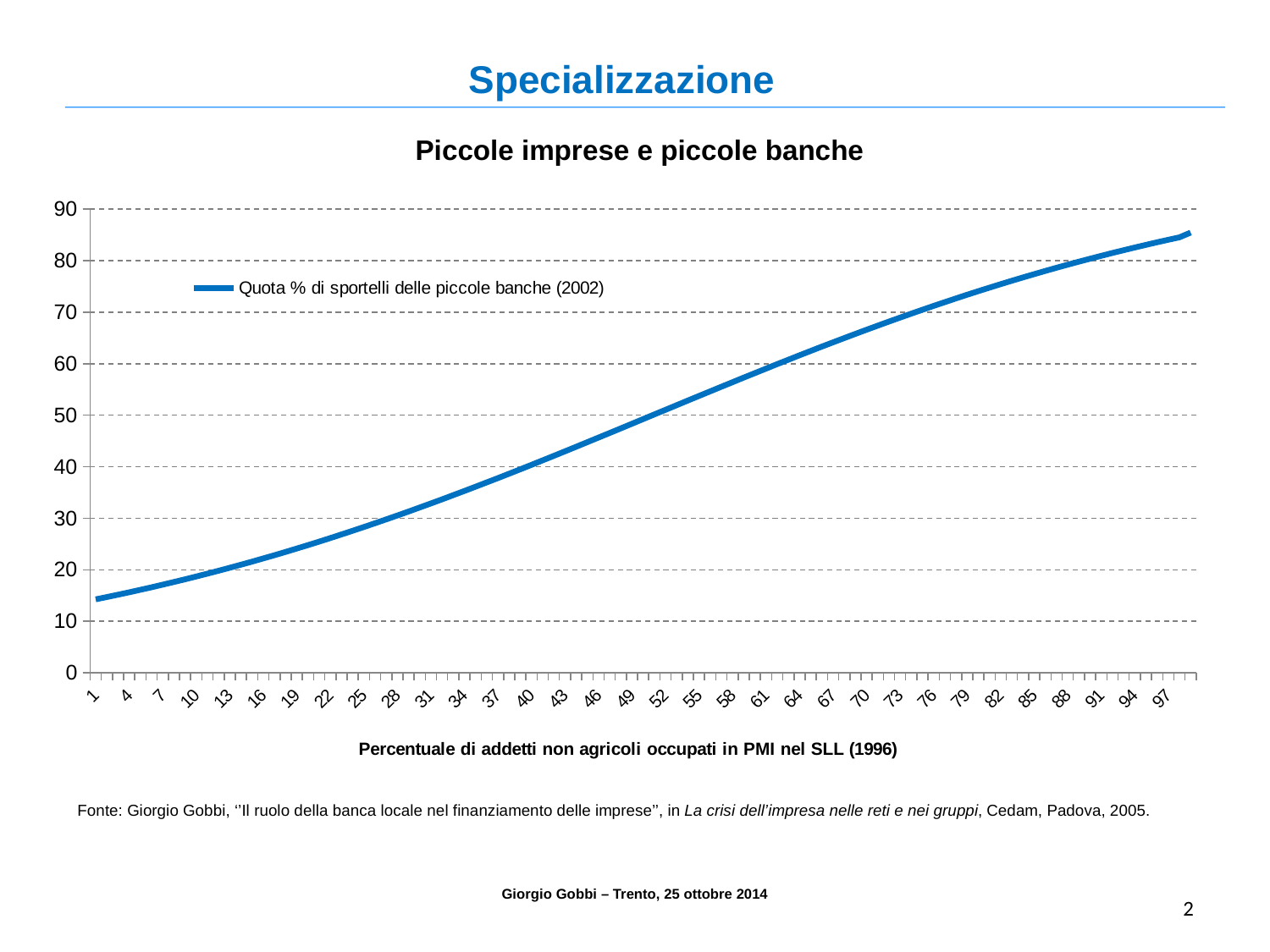
Is the value for x = 10 greater or less than 30? less Do the values of the series rise or fall as you move along the x axis from 1 to 97? rise What kind of chart is shown on the slide? line chart Is the value for x = 25 greater or less than 20? greater Which is larger, the value at x = 13 or the value at x = 61? x = 61 Is the value for x = 97 greater or less than 80? greater What is the title of the chart? Piccole imprese e piccole banche How many series does the legend list? 1 What is the legend entry for the plotted series? Quota % di sportelli delle piccole banche (2002)